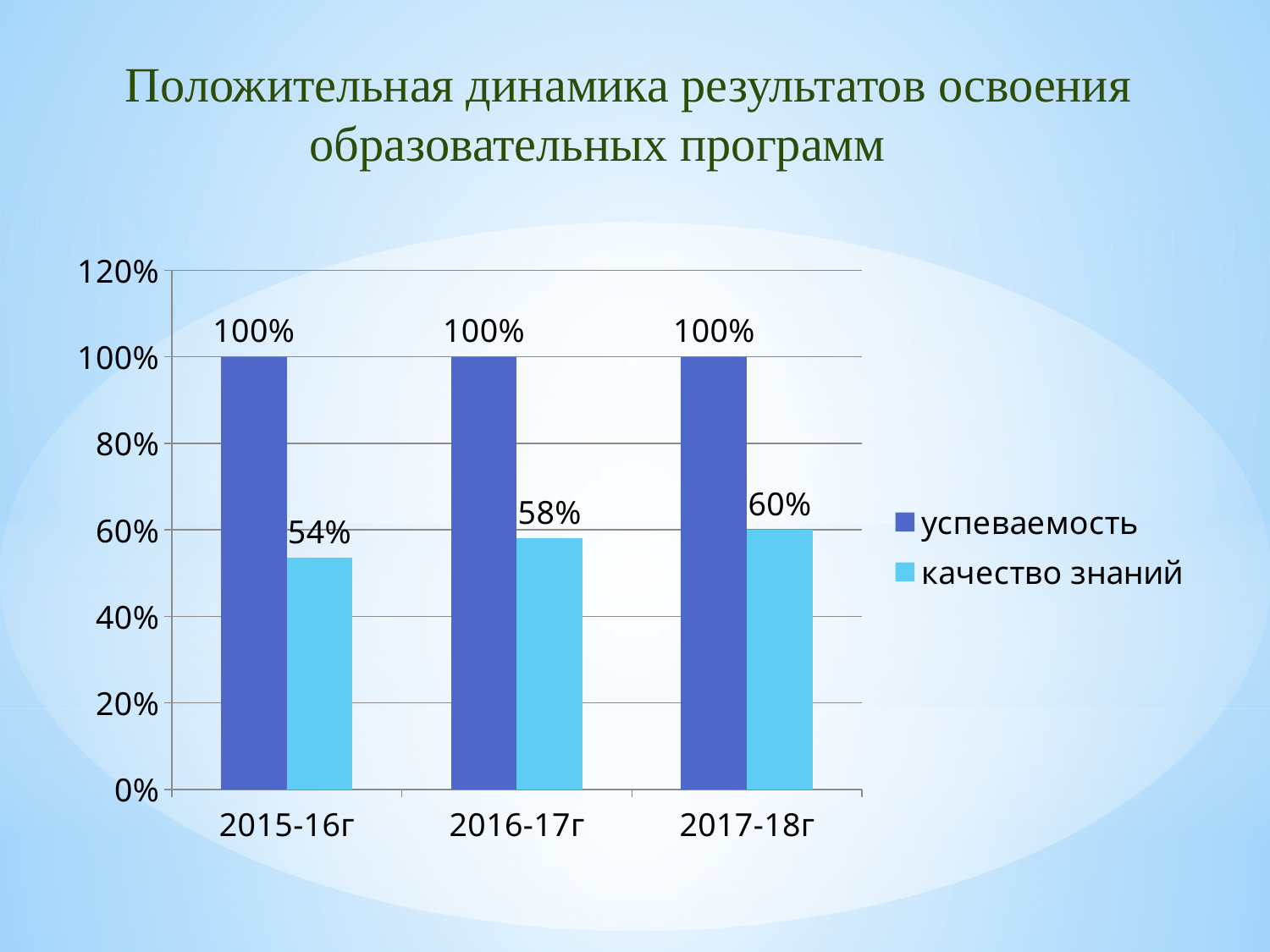
What is the difference between качество знаний in 2017-18г and 2015-16г? 6% What is the value of качество знаний for 2017-18г? 60% How many year categories are shown on the x axis? 3 Which year has the lowest value for качество знаний? 2015-16г Which is larger: качество знаний in 2016-17г or in 2015-16г? 2016-17г What is the value of успеваемость for 2016-17г? 100% What is the value of качество знаний for 2015-16г? 54% Does качество знаний rise or fall from 2015-16г to 2017-18г? rise What kind of chart is shown on the slide? bar chart Which year has the highest value for качество знаний? 2017-18г How many series does the legend list? 2 Is the value of качество знаний for 2016-17г greater or less than 40%? greater